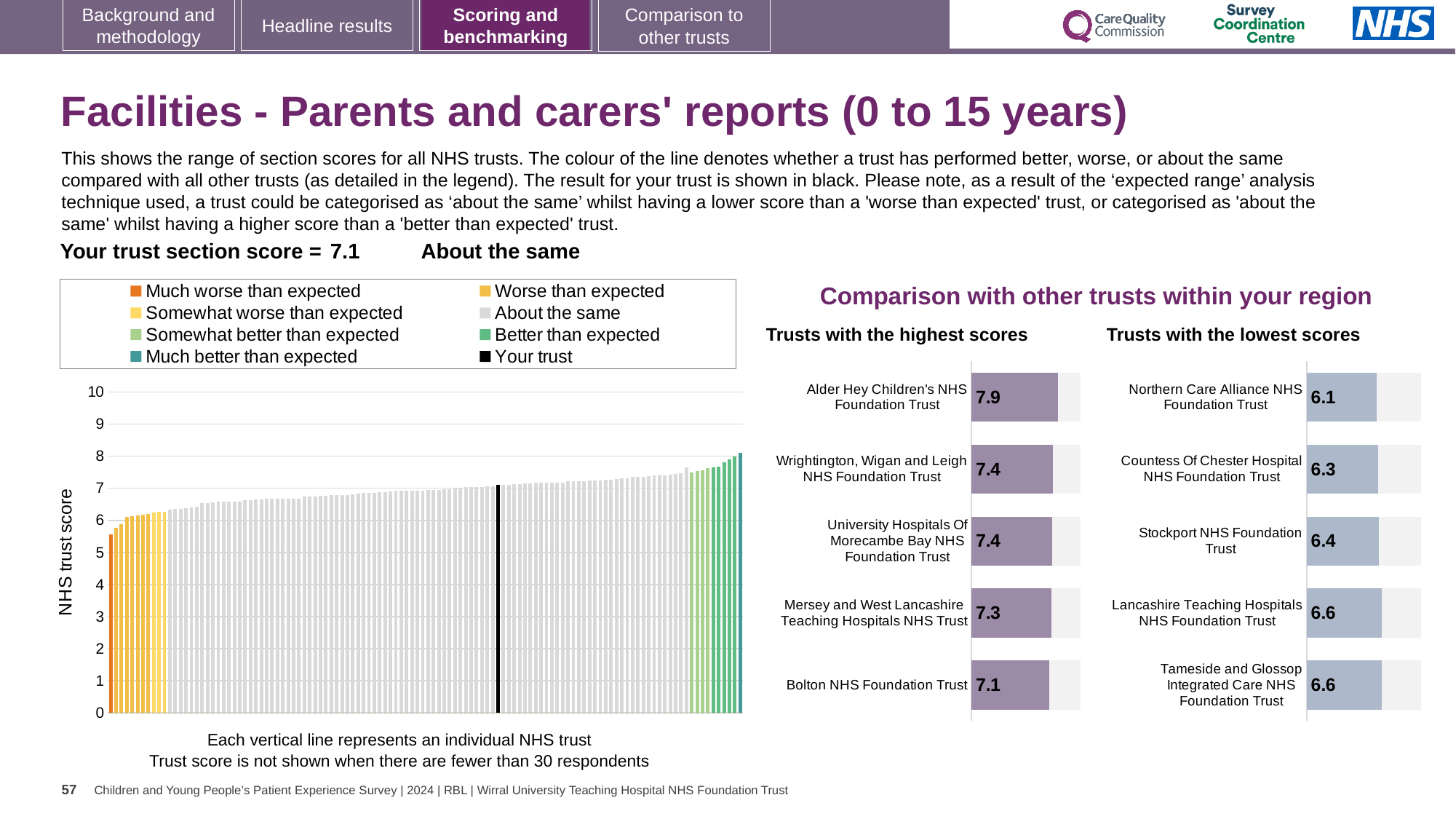
In the 'Trusts with the highest scores' chart, what is the score for Alder Hey Children's NHS Foundation Trust? 7.9 In the main NHS trust score chart, what is your trust's section score? 7.1 In the 'Trusts with the lowest scores' chart, which trust has the lowest score? Northern Care Alliance NHS Foundation Trust How many entries does the legend of the main NHS trust score chart list? 8 In the main NHS trust score chart, do the trust scores rise or fall from left to right along the x axis? Rise How many trusts are shown in the 'Trusts with the highest scores' chart? 5 In the 'Trusts with the highest scores' chart, what is the difference between the scores of Alder Hey Children's NHS Foundation Trust and Bolton NHS Foundation Trust? 0.8 What kind of chart is the main chart showing NHS trust scores on the left of the slide? Bar chart In the 'Trusts with the lowest scores' chart, which has the larger score: Countess Of Chester Hospital NHS Foundation Trust or Stockport NHS Foundation Trust? Stockport NHS Foundation Trust In the 'Trusts with the lowest scores' chart, what is the difference between the scores of Lancashire Teaching Hospitals NHS Foundation Trust and Northern Care Alliance NHS Foundation Trust? 0.5 In the 'Trusts with the lowest scores' chart, what is the score for Northern Care Alliance NHS Foundation Trust? 6.1 In the 'Trusts with the highest scores' chart, which trust has the highest score? Alder Hey Children's NHS Foundation Trust